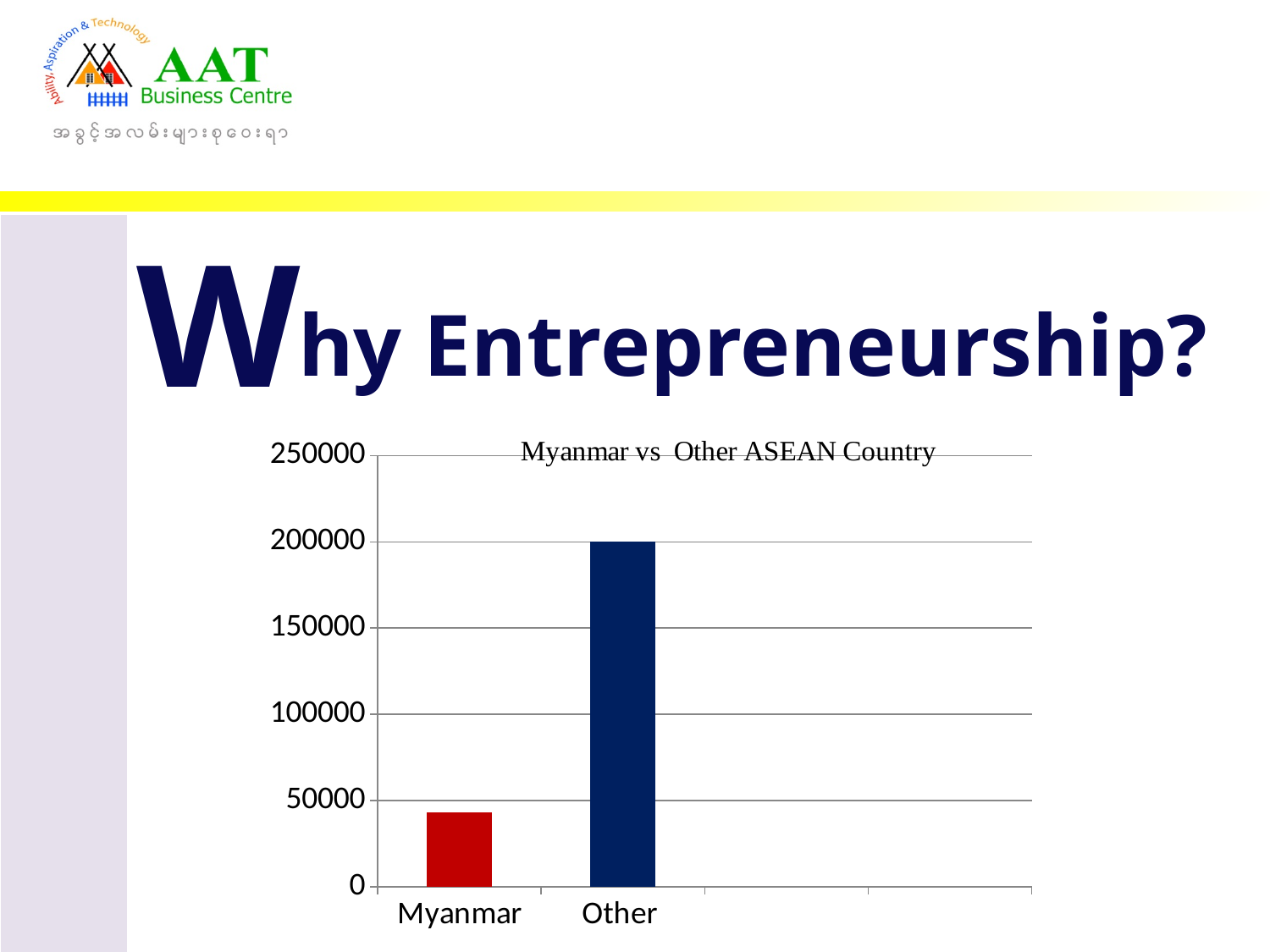
What is the value for Other? 200000 Which is larger, the value for Myanmar or the value for Other? Other Is the value for Other greater or less than 150000? greater Is the value for Myanmar greater or less than 50000? less What colour is the bar for Myanmar? red What is the highest value shown on the vertical axis? 250000 Which category has the lowest value? Myanmar Do the values rise or fall from Myanmar to Other along the x axis? rise How many categories are plotted in the chart? 2 Which category has the highest value? Other What kind of chart is shown on the slide? bar chart What is the title of the chart? Myanmar vs Other ASEAN Country